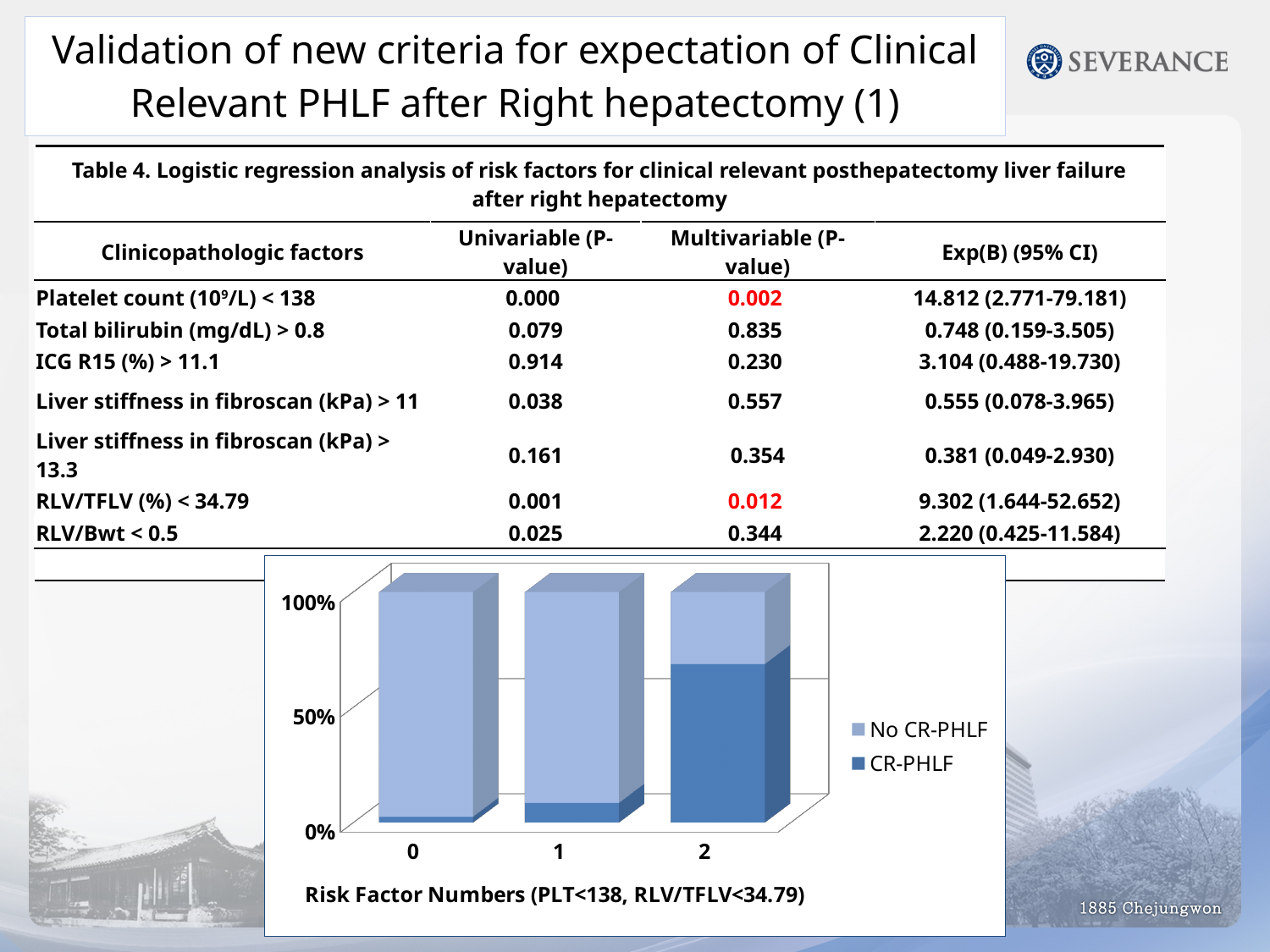
How many series does the chart legend list? 2 What are the two series named in the chart legend? No CR-PHLF and CR-PHLF Does the CR-PHLF share rise or fall as the risk factor number increases from 0 to 2? rise Is the No CR-PHLF share for risk factor number 1 greater or less than 50%? greater Which risk factor number has the lowest CR-PHLF share? 0 What kind of chart is shown at the bottom of the slide? Stacked bar chart How many categories are shown on the x axis of the chart? 3 Which risk factor number has the highest CR-PHLF share? 2 Is the CR-PHLF share for risk factor number 2 greater or less than 50%? greater What is the x-axis title of the chart? Risk Factor Numbers (PLT<138, RLV/TFLV<34.79) Which has the larger CR-PHLF share, risk factor number 1 or risk factor number 2? 2 Is the CR-PHLF share for risk factor number 0 greater or less than 50%? less